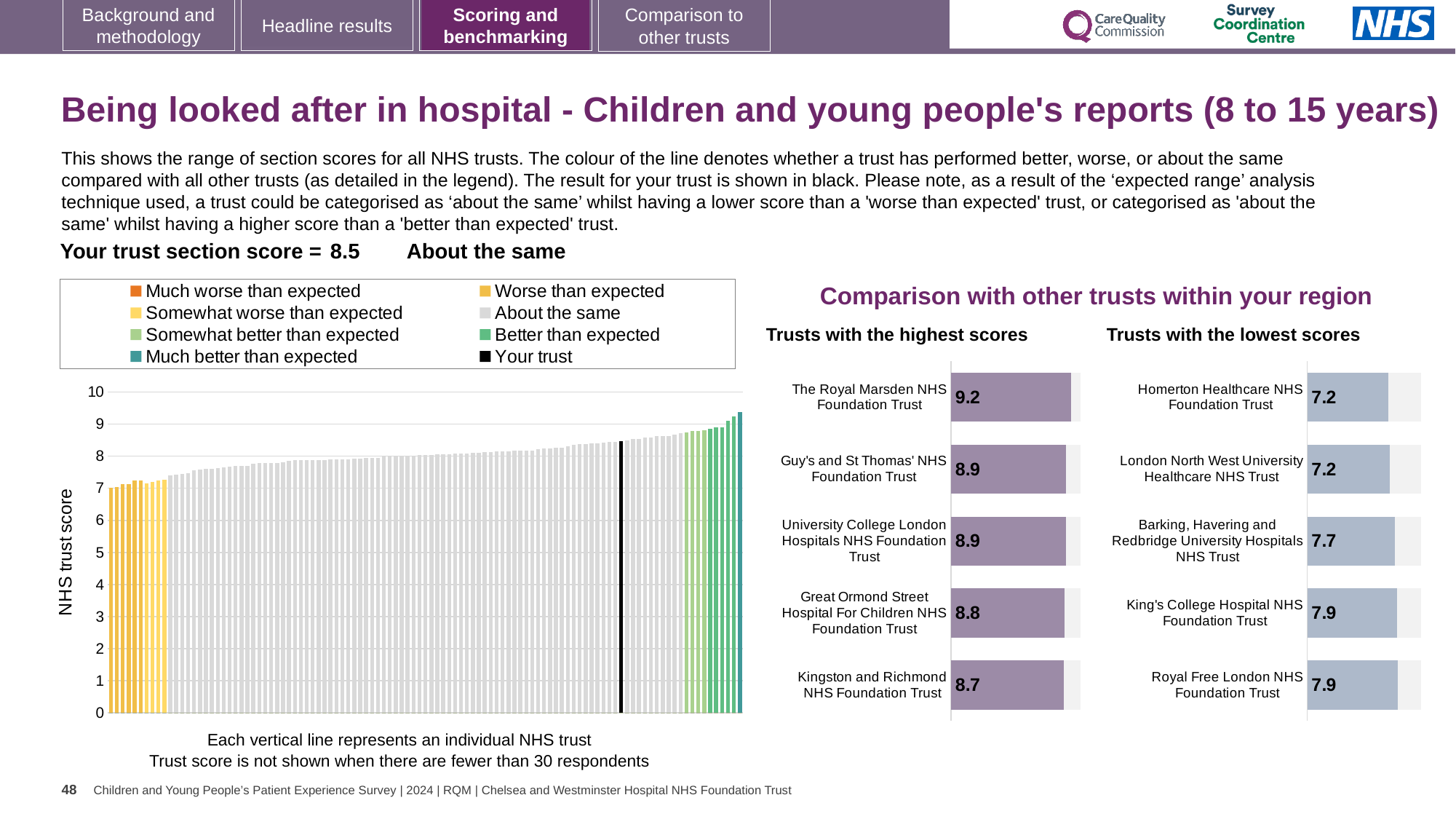
In the 'Trusts with the highest scores' chart, what is the score for The Royal Marsden NHS Foundation Trust? 9.2 In the 'Trusts with the highest scores' chart, which trust has the highest score? The Royal Marsden NHS Foundation Trust How many trusts are listed in the 'Trusts with the lowest scores' chart? 5 In the 'Trusts with the highest scores' chart, what is the difference between the scores of The Royal Marsden NHS Foundation Trust and Kingston and Richmond NHS Foundation Trust? 0.5 In the 'Trusts with the lowest scores' chart, what is the score for Barking, Havering and Redbridge University Hospitals NHS Trust? 7.7 In the large chart on the left, do the trust scores rise or fall from left to right? Rise In the large chart on the left, is the value for the black 'Your trust' bar greater or less than 8? greater What kind of chart is the large chart on the left showing NHS trust scores? Bar chart In the 'Trusts with the highest scores' chart, what is the score for Kingston and Richmond NHS Foundation Trust? 8.7 How many entries does the legend of the large chart on the left list? 8 In the 'Trusts with the lowest scores' chart, what is the difference between the scores of King's College Hospital NHS Foundation Trust and Homerton Healthcare NHS Foundation Trust? 0.7 In the 'Trusts with the lowest scores' chart, which has the larger score: Royal Free London NHS Foundation Trust or London North West University Healthcare NHS Trust? Royal Free London NHS Foundation Trust